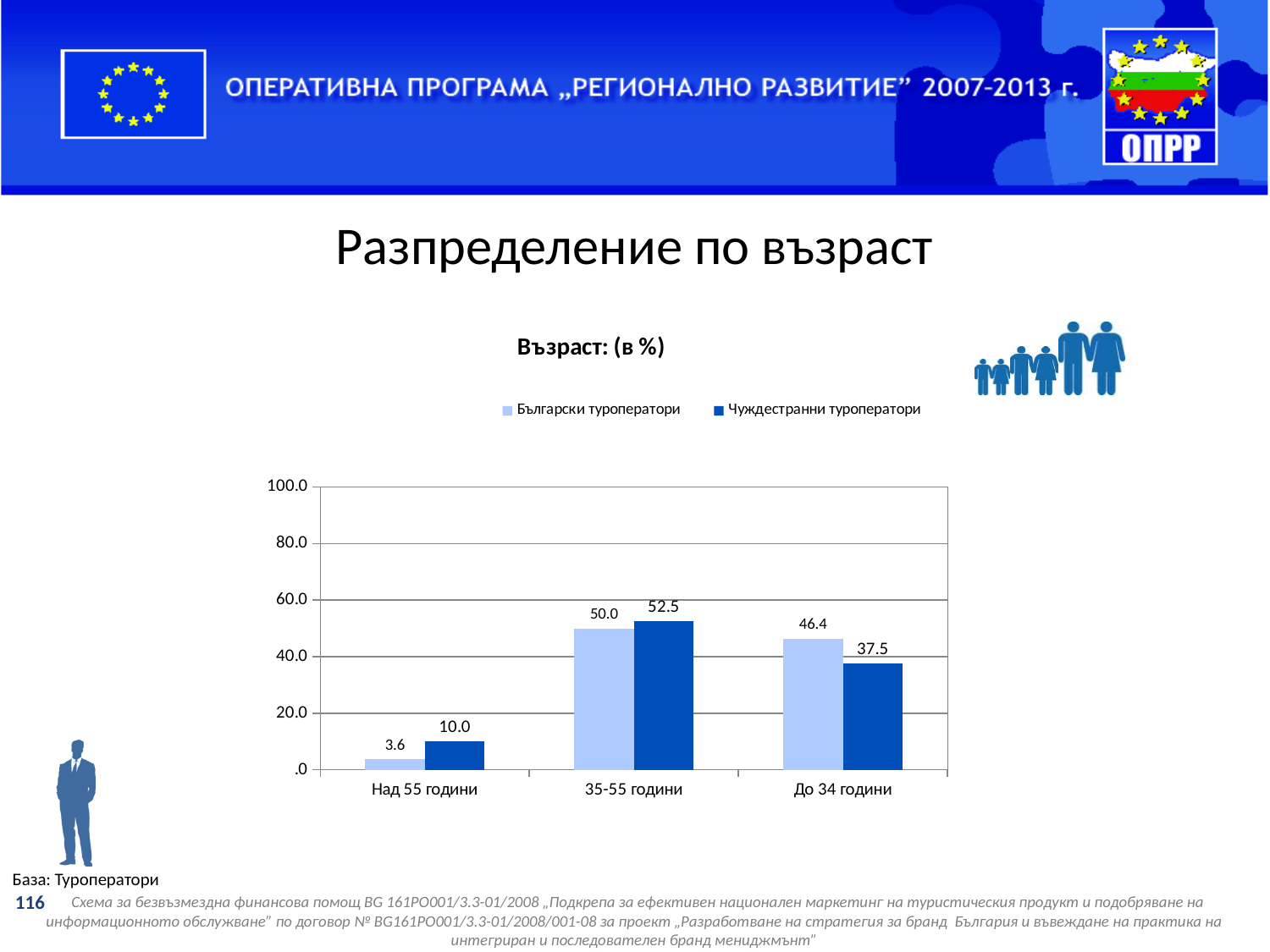
What is the difference between Български туроператори and Чуждестранни туроператори in the До 34 години category? 8.9 What is the value for Чуждестранни туроператори in the 35-55 години category? 52.5 What kind of chart is shown on the slide? bar chart What is the title of the chart? Възраст: (в %) Which age category has the lowest value for Чуждестранни туроператори? Над 55 години Is the value for Български туроператори in the 35-55 години category greater or less than 40.0? greater Which age category has the highest value for Български туроператори? 35-55 години What is the value for Чуждестранни туроператори in the До 34 години category? 37.5 How many series does the legend list? 2 What is the value for Български туроператори in the Над 55 години category? 3.6 In the Над 55 години category, which series has the larger value? Чуждестранни туроператори How many age categories are shown on the x axis? 3